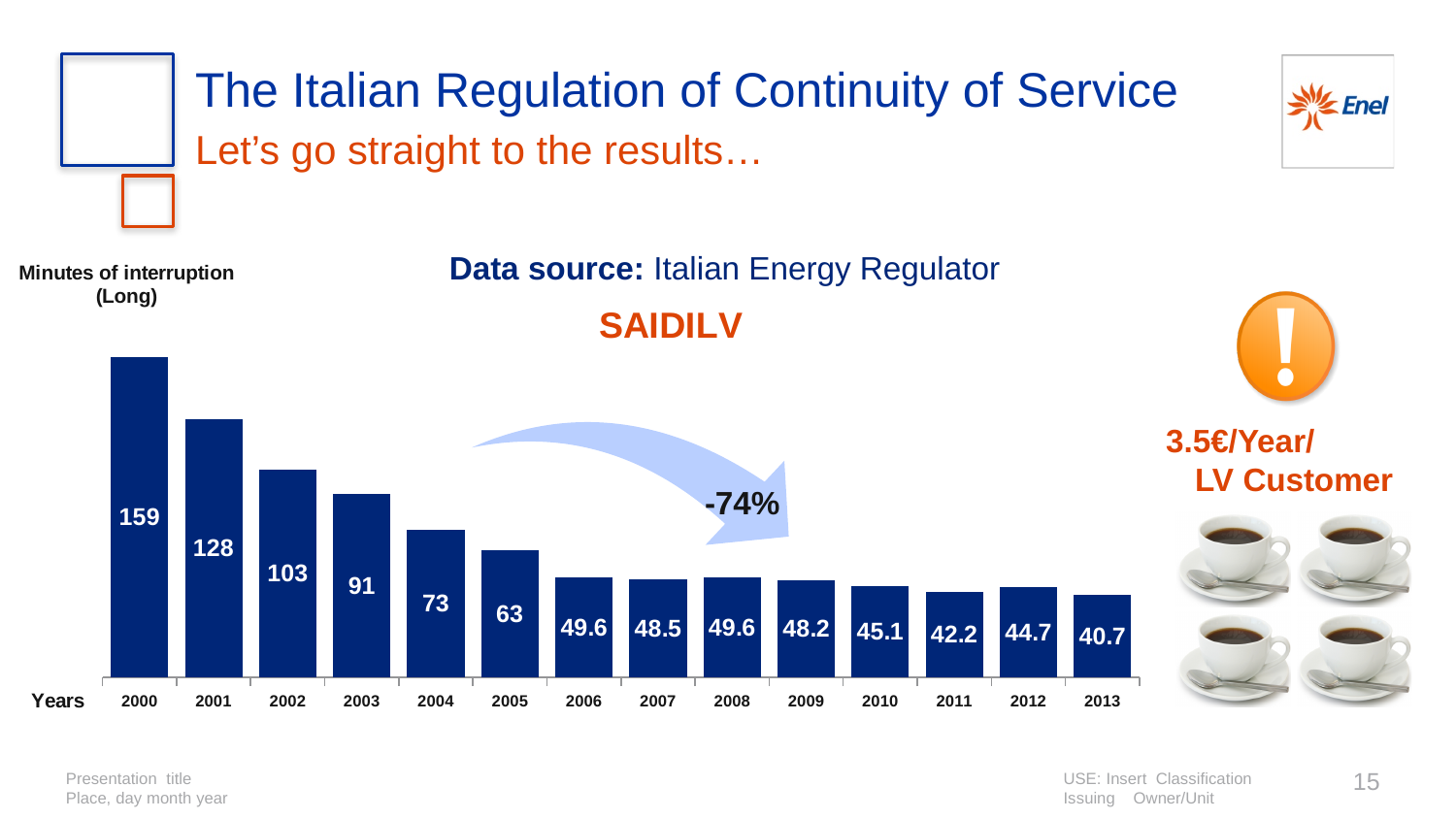
Do the values generally rise or fall from 2000 to 2013? fall What is the value for 2006? 49.6 Which year has the highest value? 2000 What is the title of the chart? SAIDILV What is the difference between the values for 2009 and 2010? 3.1 Which year has the lowest value? 2013 What is the value for 2013? 40.7 How many years are shown on the x axis? 14 What is the value for 2000? 159 Which is larger, the value for 2011 or the value for 2012? 2012 What kind of chart is this? bar chart What is the difference between the values for 2000 and 2001? 31